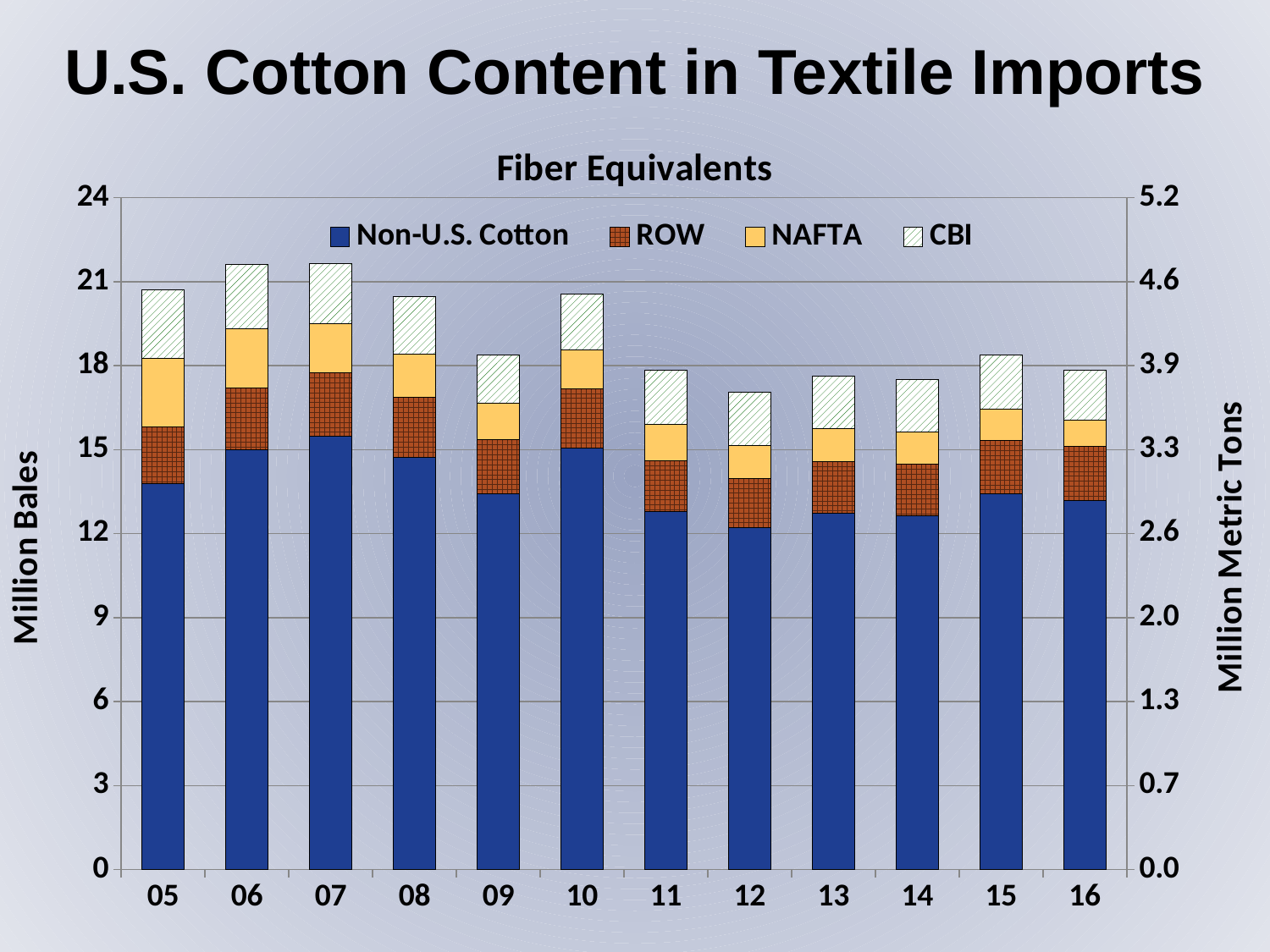
Is the Non-U.S. Cotton value for 11 greater or less than 12 million bales? greater Is the total bar height for 05 greater or less than 18 million bales? greater How many series does the chart's legend list? 4 What is the label of the left vertical axis? Million Bales How many years are shown along the x axis of the chart? 12 Which year has the larger total bar, 06 or 12? 06 Which year has the lowest total bar height? 12 Is the total bar height for 12 greater or less than 18 million bales? less What kind of chart is shown on the slide? Stacked bar chart What is the label of the right vertical axis? Million Metric Tons Do the total bar heights rise or fall from 10 to 12? fall